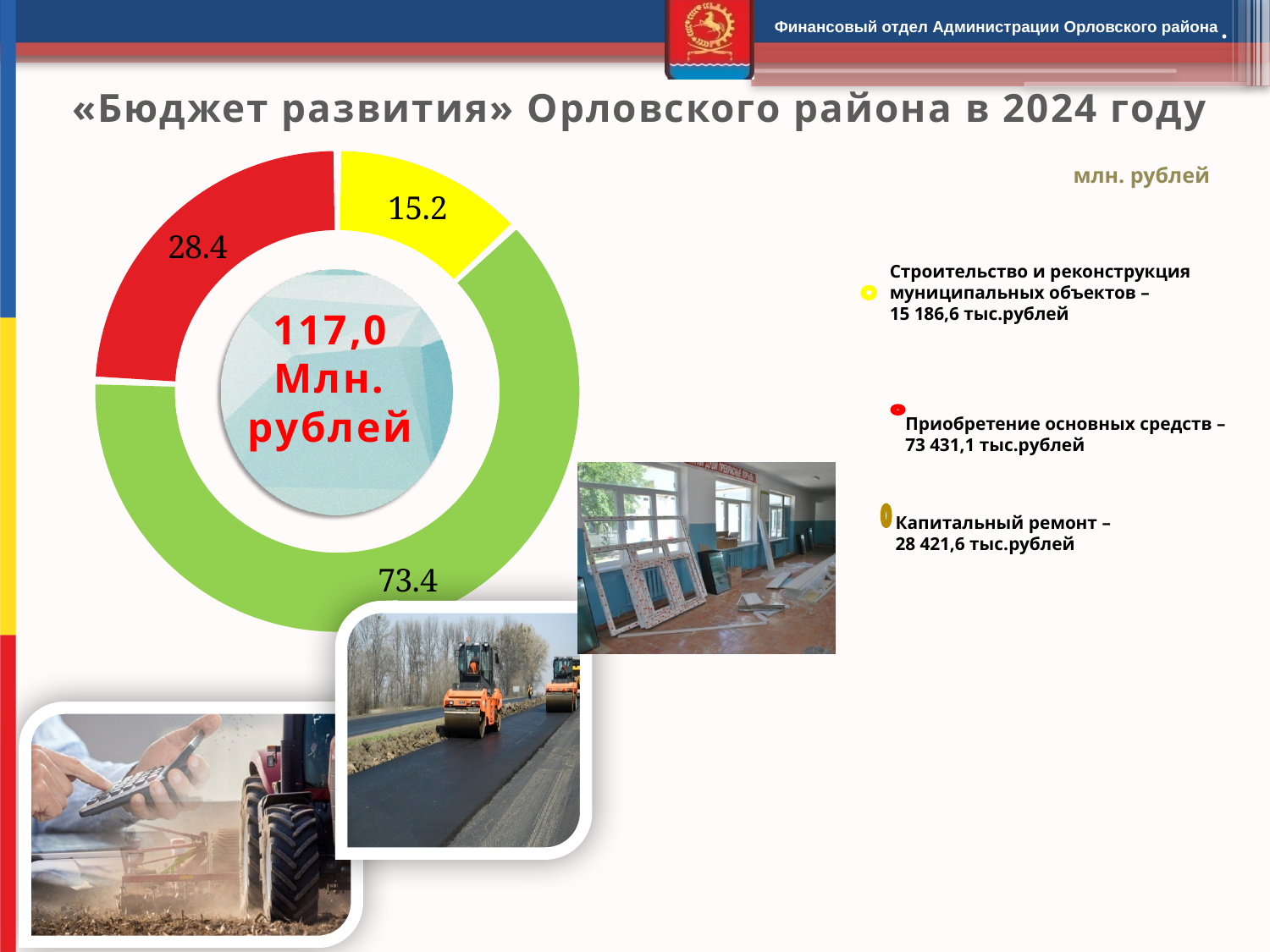
Which category has the largest slice of the chart? Приобретение основных средств How many slices does the doughnut chart have? 3 Which is larger: the value for Капитальный ремонт or the value for Строительство и реконструкция муниципальных объектов? Капитальный ремонт What is the difference between the red slice (28.4) and the yellow slice (15.2)? 13.2 What unit is indicated for the chart values? млн. рублей What total is printed in the centre of the doughnut chart? 117,0 Млн. рублей What type of chart is shown on the slide? Doughnut (pie) chart What value is shown for the green slice (Приобретение основных средств)? 73.4 What value is shown for the red slice (Капитальный ремонт)? 28.4 What is the difference between the green slice (73.4) and the red slice (28.4)? 45.0 What value is shown for the yellow slice (Строительство и реконструкция муниципальных объектов)? 15.2 Which category has the smallest slice of the chart? Строительство и реконструкция муниципальных объектов